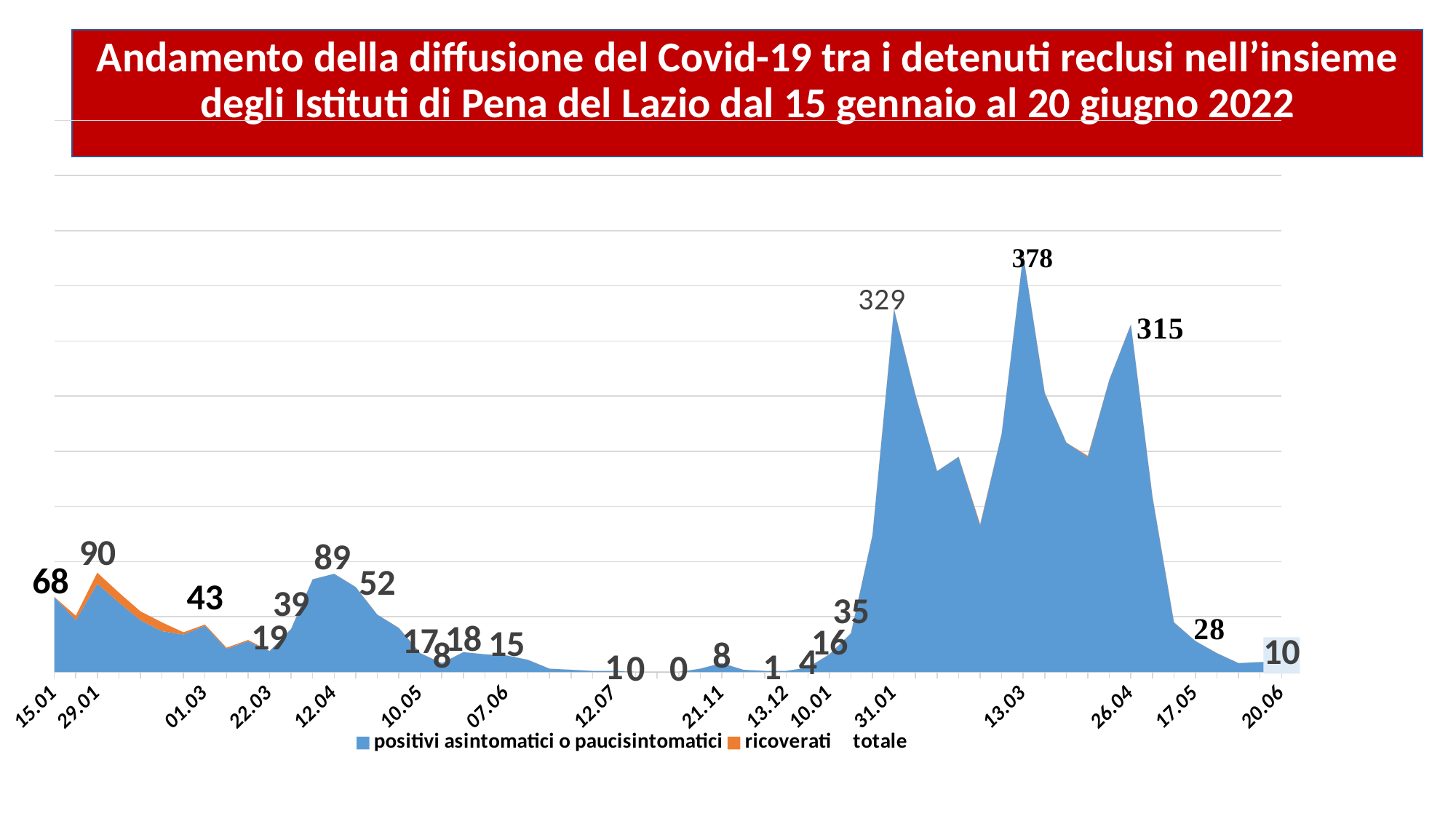
What is the value labelled at 26.04? 315 Do the values rise or fall from 26.04 to 20.06? Fall How many series does the legend list? 3 What is the value labelled at the last point, 20.06? 10 What kind of chart is shown on the slide? Area chart Which is larger, the value labelled 329 at 31.01 or the value labelled 315 at 26.04? 329 at 31.01 What is the value labelled at 13.03? 378 What is the lowest value labelled on the chart? 0 What is the value labelled at 29.01? 90 What is the value labelled at the first point, 15.01? 68 What is the difference between the peak value 378 and the later peak value 315? 63 What is the highest value labelled on the chart? 378